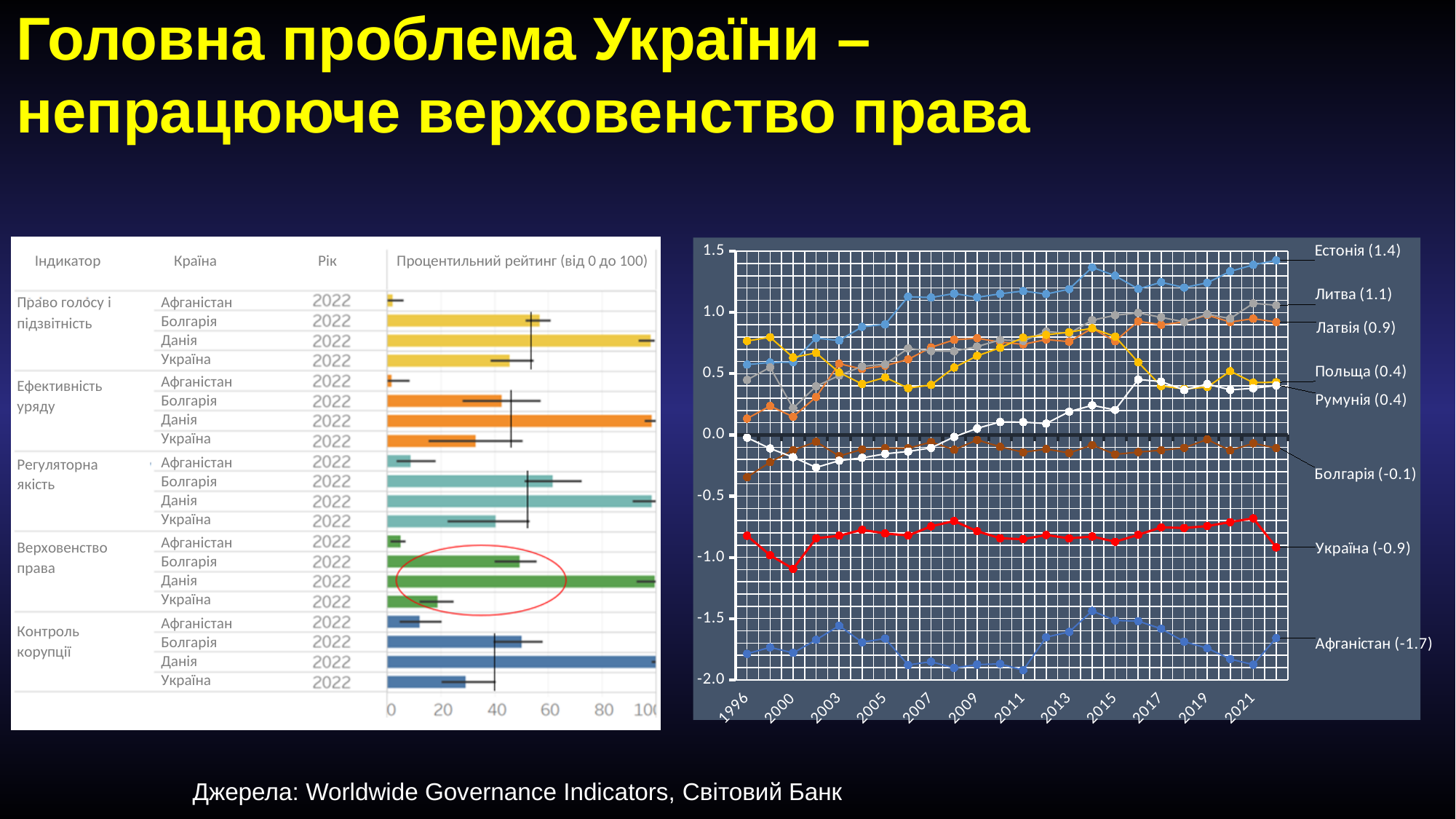
What kind of chart is on the left side of the slide? bar chart On the right line chart, which country has the lowest latest value? Афганістан On the right line chart, how many countries (series) are labelled? 8 On the left bar chart, in the Верховенство права group, which country has the highest percentile rating? Данія On the right line chart, does the line for Естонія generally rise or fall from 1996 to 2021? rise On the right line chart, what is the latest value shown for Естонія? 1.4 On the left bar chart, is the Верховенство права value for Україна greater or less than 40? less On the right line chart, which country has the highest latest value? Естонія On the right line chart, what is the latest value shown for Афганістан? -1.7 On the right line chart, what is the difference between the latest values of Естонія (1.4) and Україна (-0.9)? 2.3 On the right line chart, what is the latest value shown for Україна? -0.9 On the right line chart, which has a higher latest value, Литва or Латвія? Литва